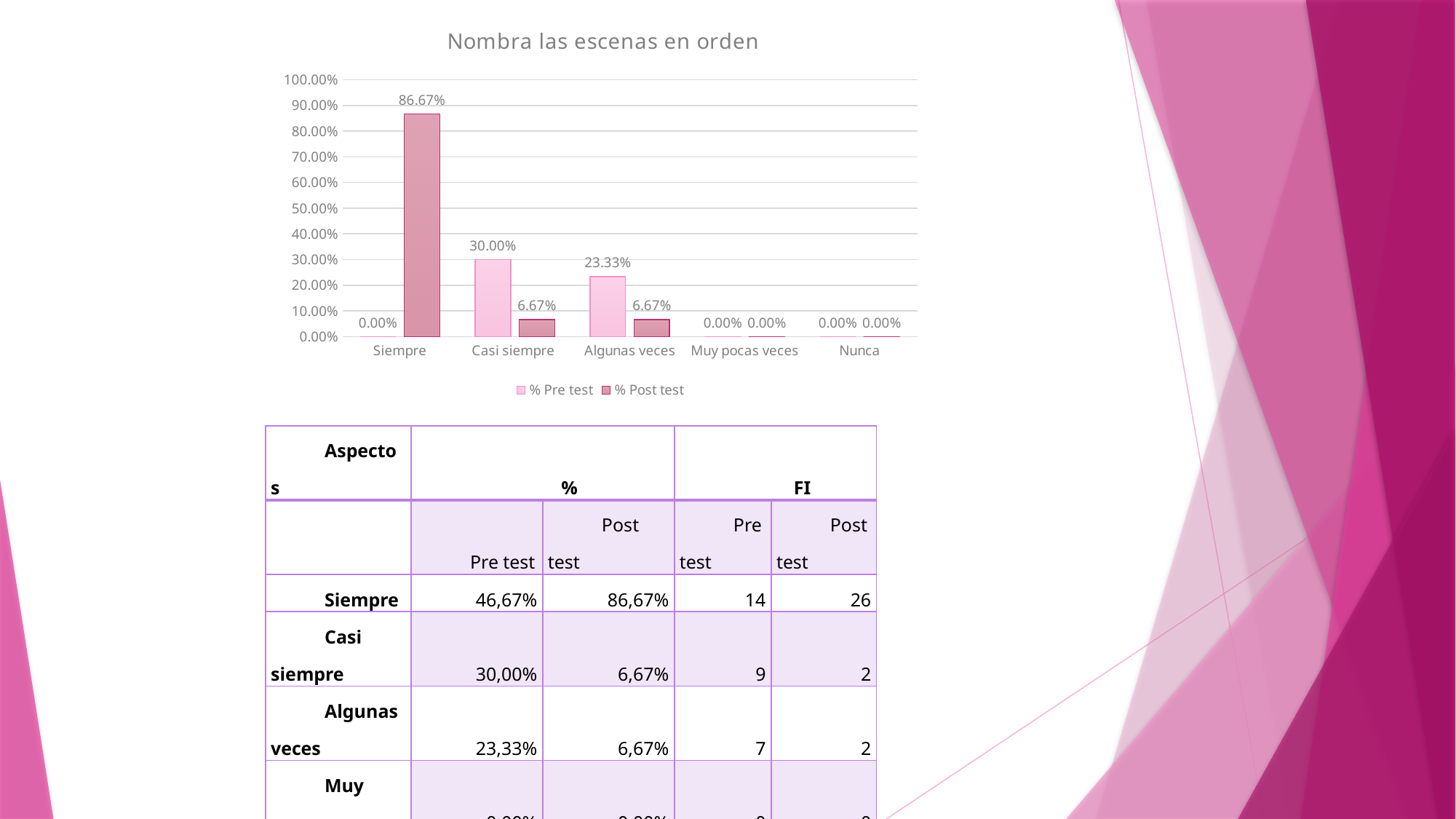
What is the title of the chart? Nombra las escenas en orden What is the % Post test value for Siempre in the chart? 86.67% Which category has the highest % Post test value in the chart? Siempre What is the % Pre test value for Algunas veces in the chart? 23.33% What is the % Post test value for Nunca in the chart? 0.00% How many categories are shown on the x axis of the chart? 5 What is the difference between the % Pre test and % Post test values for Casi siempre? 23.33% What is the % Post test value for Casi siempre in the chart? 6.67% What type of chart is shown on the slide? bar chart Which is larger for Algunas veces: the % Pre test value or the % Post test value? % Pre test How many series does the chart legend list? 2 What is the % Pre test value for Casi siempre in the chart? 30.00%